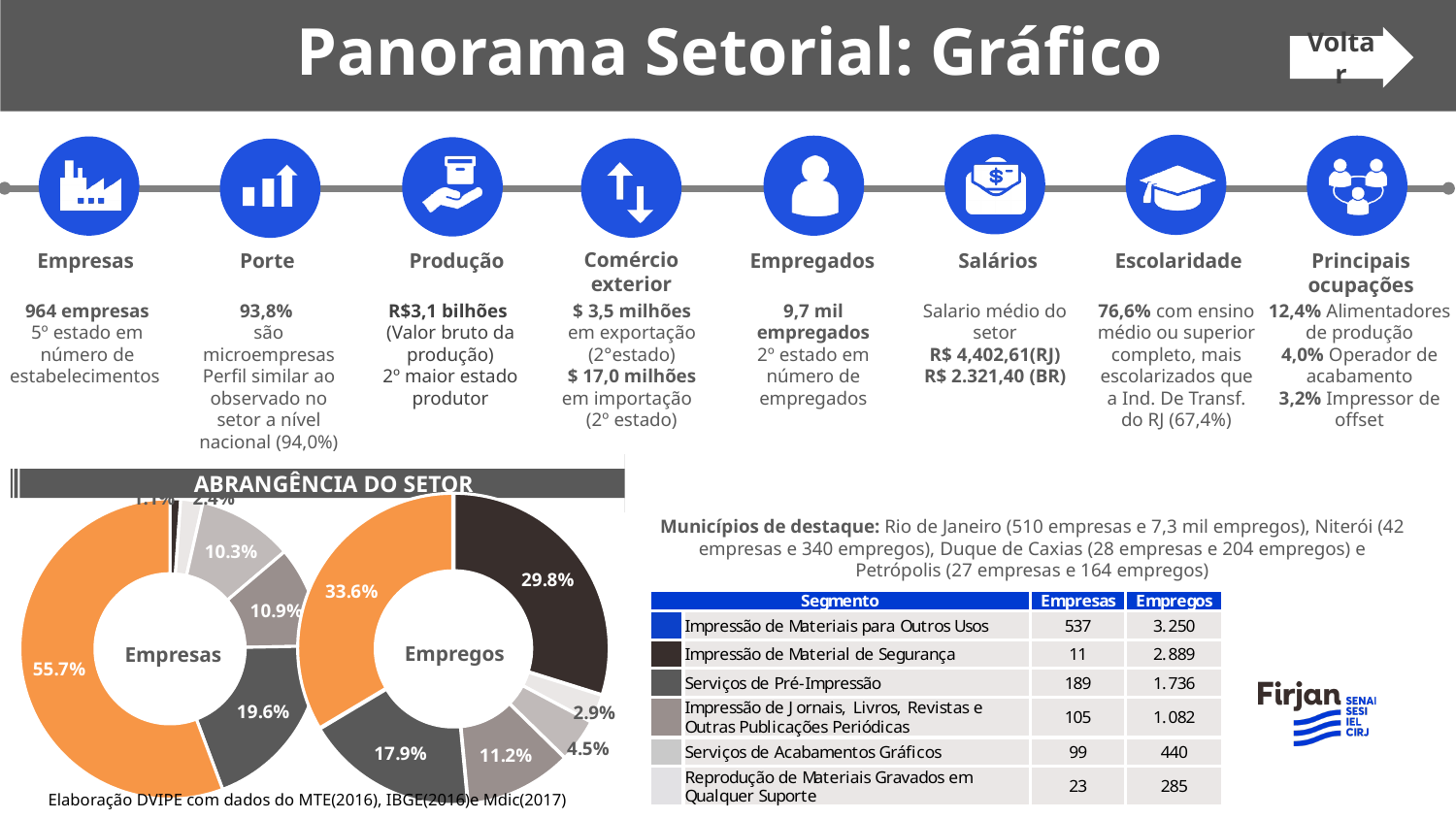
In the 'Empregos' chart, what is the difference in percentage points between the 33.6% slice and the 29.8% slice? 3.8 percentage points In the 'Empresas' chart, what is the share of the largest slice? 55.7% In the 'Empregos' chart, what is the share of the smallest slice? 2.9% What source note is printed below the donut charts? Elaboração DVIPE com dados do MTE(2016), IBGE(2016)e Mdic(2017) How many slices does the 'Empresas' chart have? 6 How many slices does the 'Empregos' chart have? 6 What kind of chart is used for the 'Empresas' and 'Empregos' charts under 'ABRANGÊNCIA DO SETOR'? pie chart (donut) In the 'Empresas' chart, what is the difference in percentage points between the 19.6% slice and the 10.9% slice? 8.7 percentage points Which chart has the larger biggest slice, 'Empresas' or 'Empregos'? Empresas In the 'Empregos' chart, what is the share of the second-largest slice? 29.8% In the 'Empregos' chart, what is the share of the largest slice? 33.6% What is the heading shown above the two donut charts? ABRANGÊNCIA DO SETOR